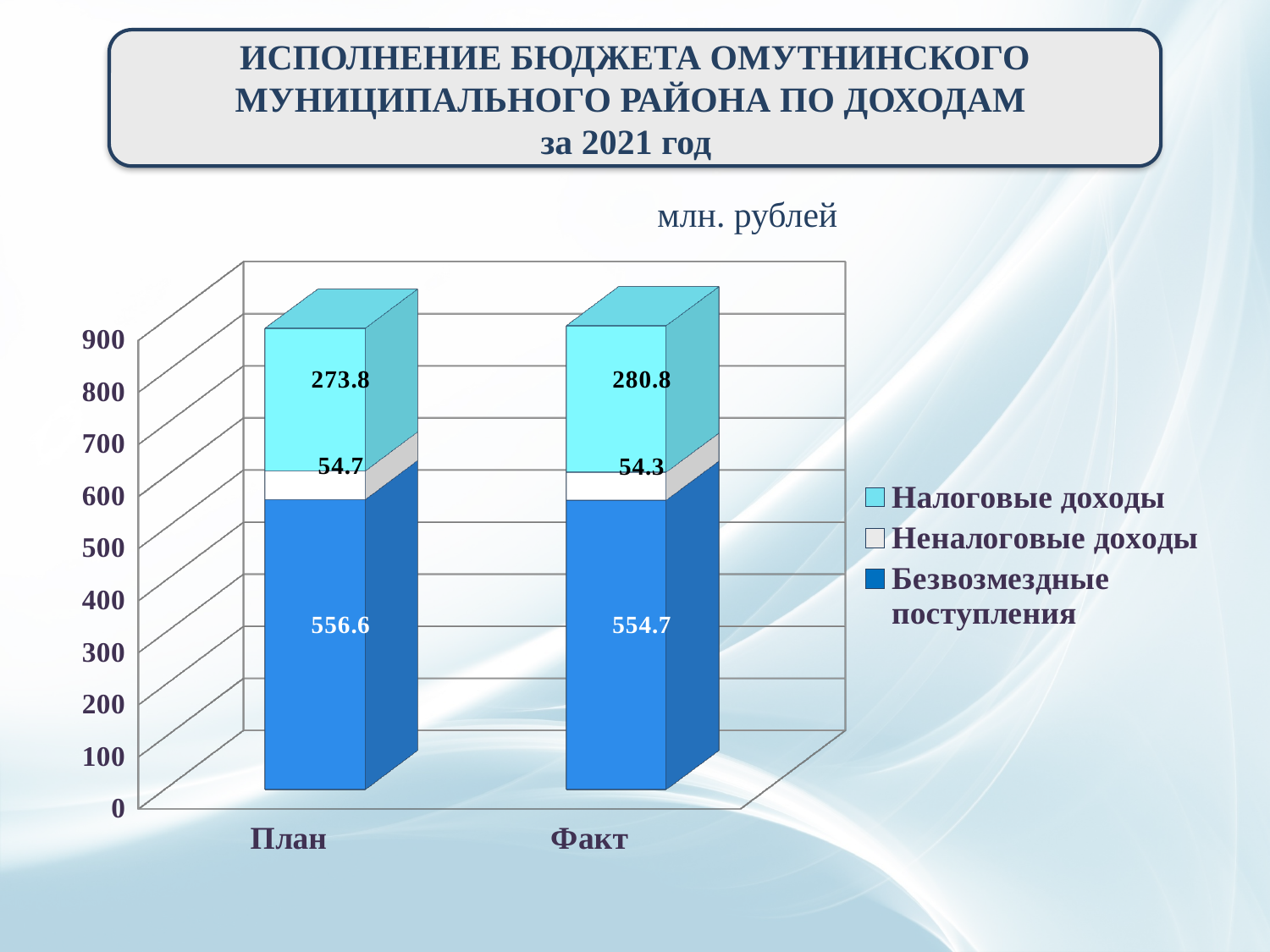
Which is larger: Безвозмездные поступления for План or for Факт? План What is the total of the Факт bar? 889.8 What is the difference between Налоговые доходы for Факт and for План? 7.0 Which series has the largest value in the Факт bar? Безвозмездные поступления Which series has the smallest value in the План bar? Неналоговые доходы What kind of chart is shown on the slide? Stacked bar chart What is the value of Налоговые доходы for План? 273.8 What is the total of the План bar? 885.1 What is the value of Неналоговые доходы for Факт? 54.3 How many series does the legend list? 3 What is the value of Безвозмездные поступления for Факт? 554.7 What is the value of Неналоговые доходы for План? 54.7